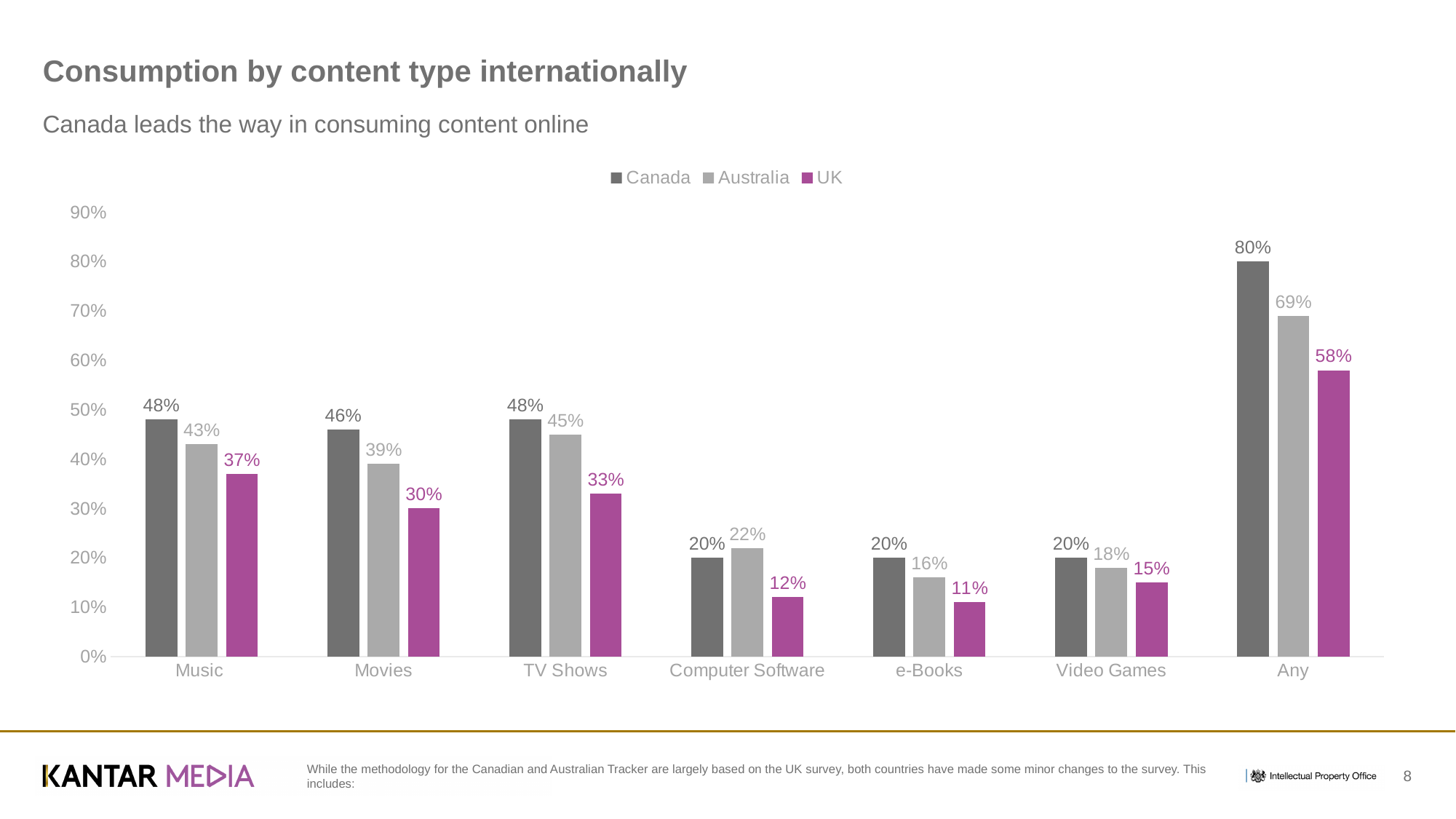
What is the value for Canada in the Music category? 48% Which category has the highest value for the UK series? Any What is the value for the UK in the Computer Software category? 12% Is the value for Canada in the Any category greater or less than 70%? greater What is the difference between the Canada and UK values for Movies? 16% How many content type categories are shown on the x axis? 7 Which is larger in the Computer Software category, the Canada value or the Australia value? Australia Which category has the lowest value for the UK series? e-Books Which series is shown in purple in the legend? UK How many series does the legend list? 3 What is the value for Australia in the Any category? 69% What kind of chart is shown on the slide? Bar chart